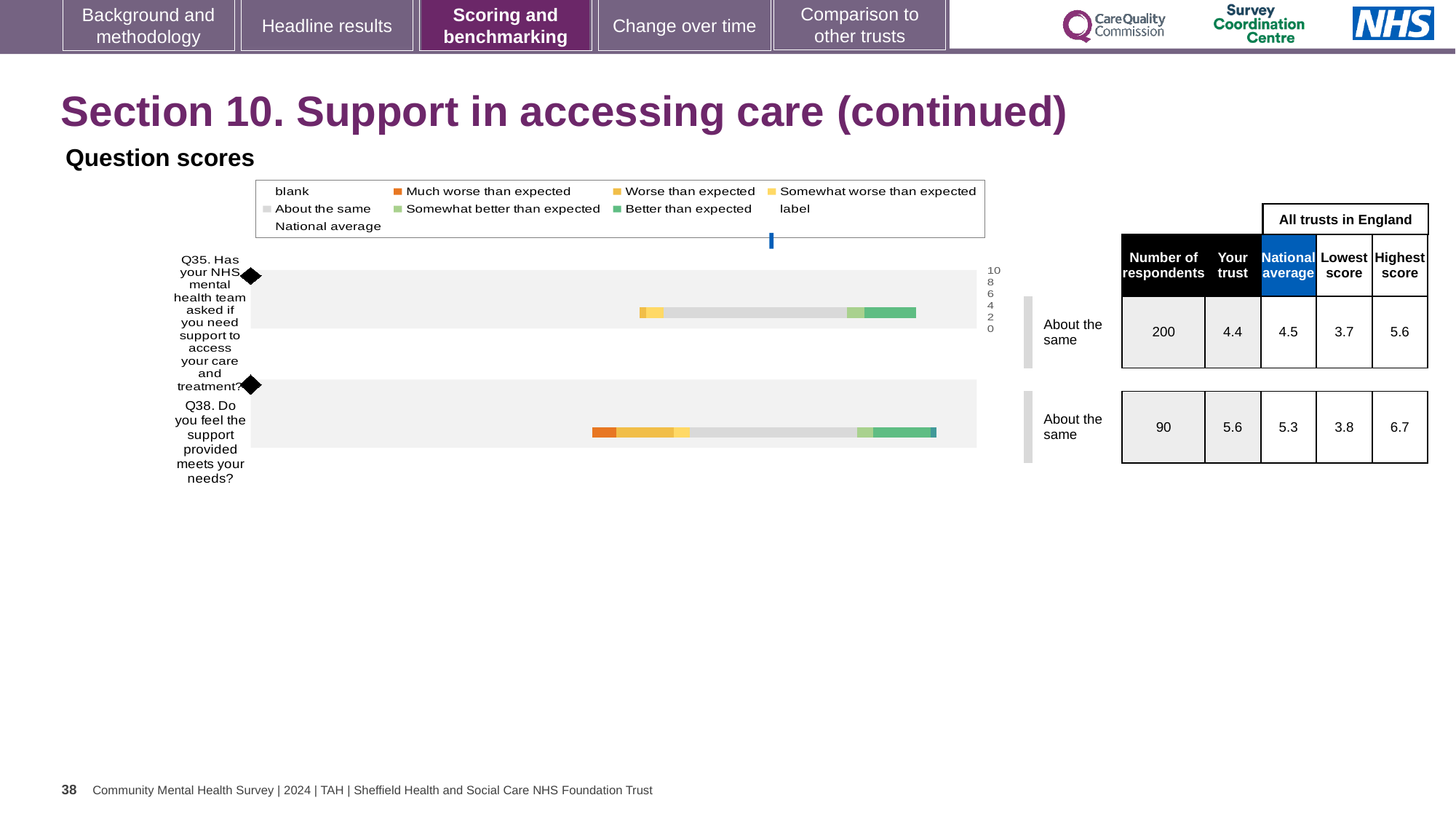
How many questions are plotted in the question scores chart? 2 What is the 'Your trust' score for Q35 (Has your NHS mental health team asked if you need support to access your care and treatment?)? 4.4 Which question has the higher 'Your trust' score, Q35 or Q38? Q38 What benchmark category is shown next to the bar for Q35? About the same What is the 'Your trust' score for Q38 (Do you feel the support provided meets your needs?)? 5.6 What is the difference between the 'Your trust' scores for Q38 and Q35? 1.2 What is the highest score among all trusts in England for Q38? 6.7 What is the national average score for Q38? 5.3 What is the difference in the number of respondents between Q35 and Q38? 110 What colour represents 'Much worse than expected' in the chart legend? Orange What kind of chart is used to show the question scores on this slide? bar chart How many respondents answered Q35? 200